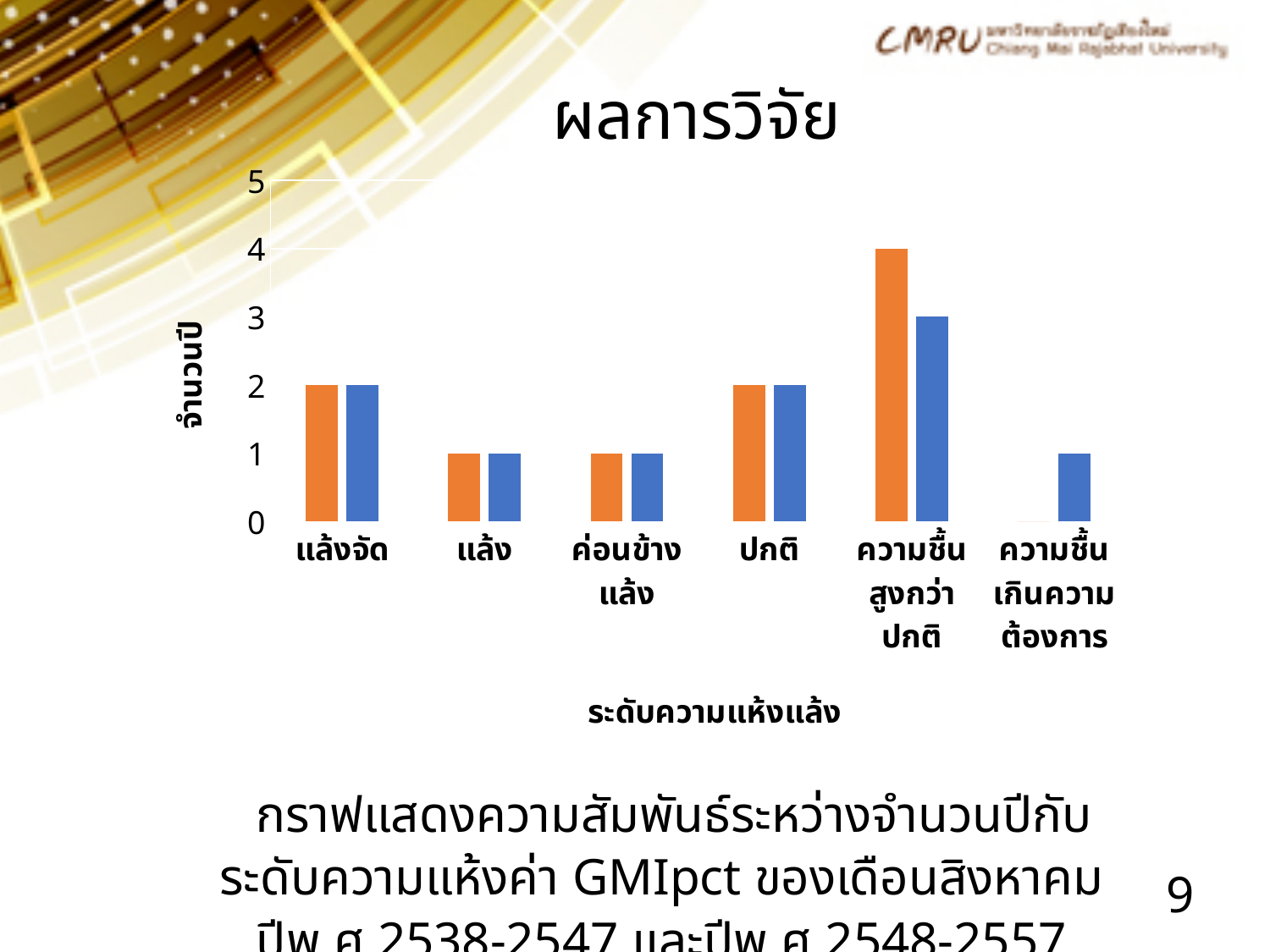
What is the difference between the orange and blue bars for ความชื้นสูงกว่าปกติ? 1 For ความชื้นสูงกว่าปกติ, which bar is larger, the orange or the blue? orange What is the value of the blue bar for ความชื้นสูงกว่าปกติ? 3 What kind of chart is shown on the slide? bar chart What is the label of the horizontal axis? ระดับความแห้งแล้ง What is the label of the vertical axis? จำนวนปี Which category has the highest blue bar? ความชื้นสูงกว่าปกติ Which category has the highest orange bar? ความชื้นสูงกว่าปกติ What is the value of the blue bar for ความชื้นเกินความต้องการ? 1 How many categories are shown on the x axis of the chart? 6 What is the value of the orange bar for แล้งจัด? 2 What is the value of the orange bar for ความชื้นสูงกว่าปกติ? 4